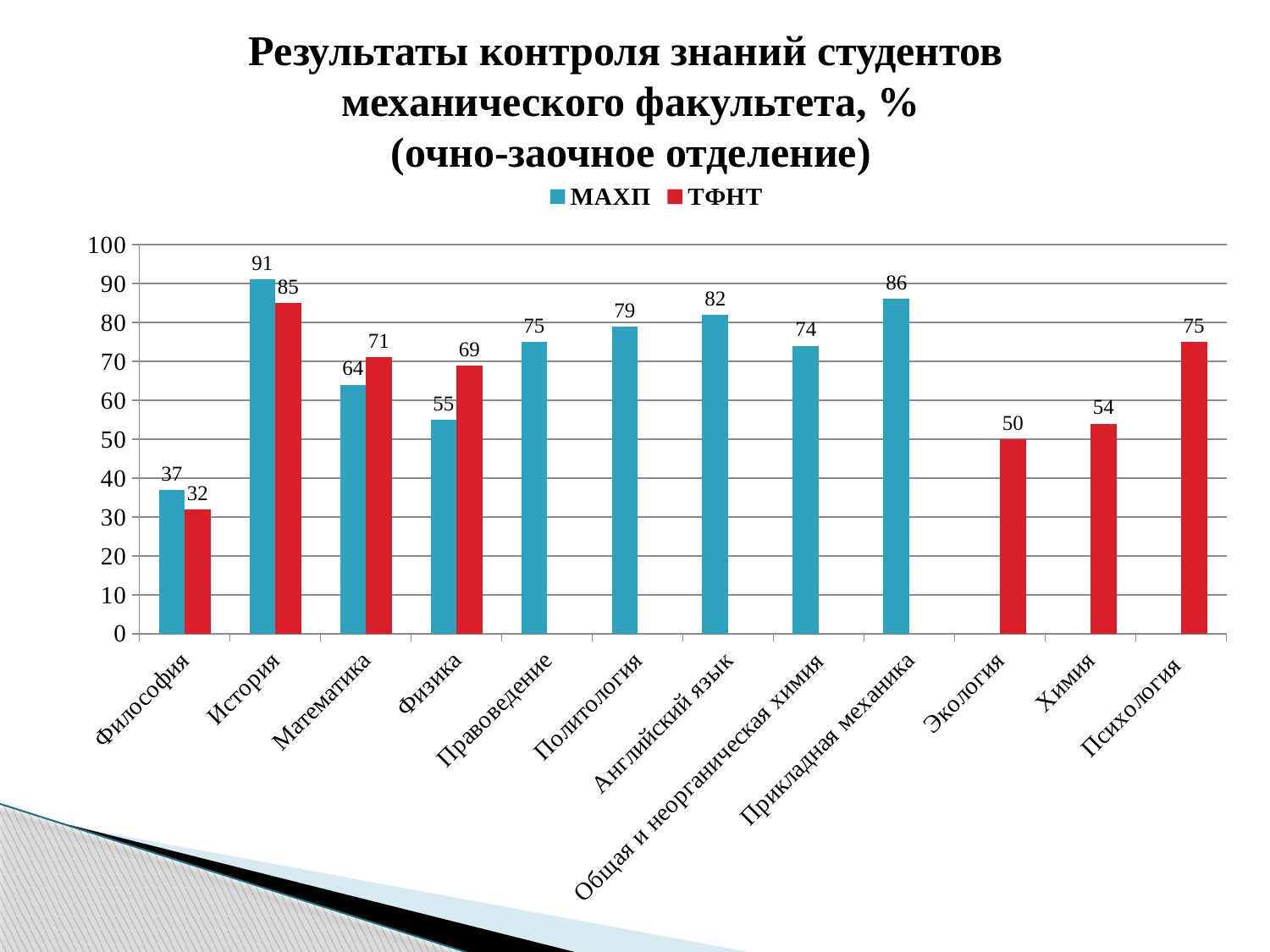
Which category has the lowest ТФНТ value? Философия Which category has the highest МАХП value? История What is the МАХП value for История? 91 What is the МАХП value for Прикладная механика? 86 What colour are the ТФНТ bars? Red What kind of chart is shown on the slide? Bar chart How many series does the legend list? 2 What is the ТФНТ value for Физика? 69 What is the difference between the МАХП and ТФНТ values for Математика? 7 What is the ТФНТ value for Психология? 75 For Философия, which series has the larger value, МАХП or ТФНТ? МАХП How many categories are shown on the x axis? 12